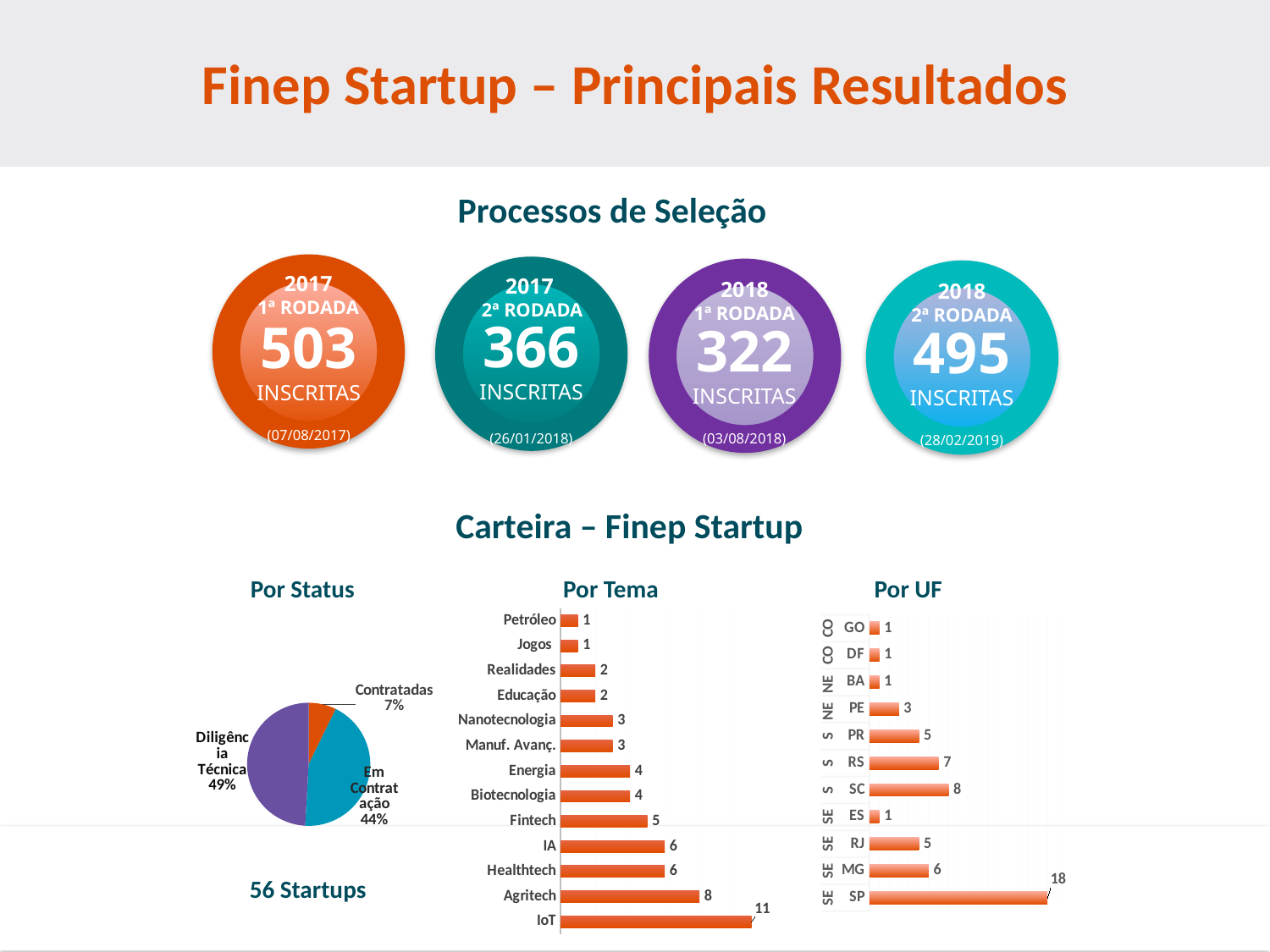
In the 'Por Tema' chart, which category has the highest value? IoT In the 'Por Tema' chart, what is the difference between the values for IoT and Agritech? 3 In the 'Por Tema' chart, how many categories are plotted? 13 In the 'Por UF' chart, what is the value for SP? 18 In the 'Por Status' chart, what share of the pie is 'Diligência Técnica'? 49% In the 'Por UF' chart, which is larger, the value for SC or the value for MG? SC In the 'Por Tema' chart, what is the value for Fintech? 5 In the 'Por Tema' chart, what is the value for IoT? 11 In the 'Por UF' chart, what is the value for RS? 7 In the 'Por UF' chart, how many UF categories are plotted? 11 In the 'Por UF' chart, what is the difference between the values for SP and SC? 10 What kind of chart is the 'Por Status' chart? Pie chart